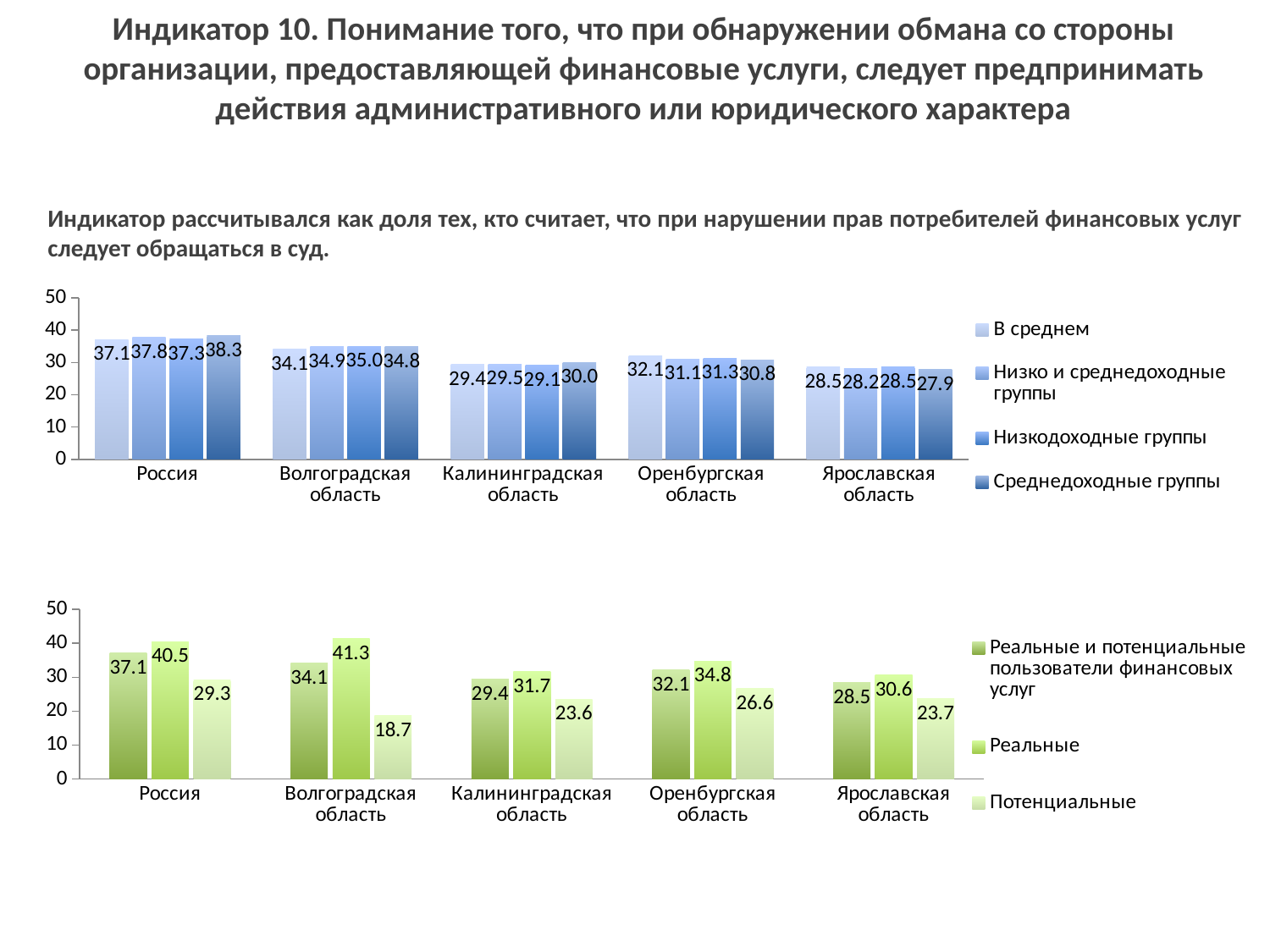
In the bottom chart, which region has the highest value in the series 'Реальные'? Волгоградская область In the bottom chart, what is the difference between the 'Реальные' and 'Потенциальные' values for Россия? 11.2 In the top chart, what is the value for Россия in the series 'Среднедоходные группы'? 38.3 How many regions are shown on the x axis of the top chart? 5 In the bottom chart, which region has the lowest value in the series 'Потенциальные'? Волгоградская область In the bottom chart, is the 'Реальные' value for Волгоградская область greater or less than 40? greater In the top chart, which is larger for Оренбургская область: 'В среднем' or 'Среднедоходные группы'? В среднем In the top chart, what is the value for Калининградская область in the series 'В среднем'? 29.4 In the top chart, which region has the lowest value in the series 'Низкодоходные группы'? Ярославская область What type of chart is the bottom chart? bar chart In the bottom chart, what is the value for Волгоградская область in the series 'Потенциальные'? 18.7 How many series does the legend of the top chart list? 4